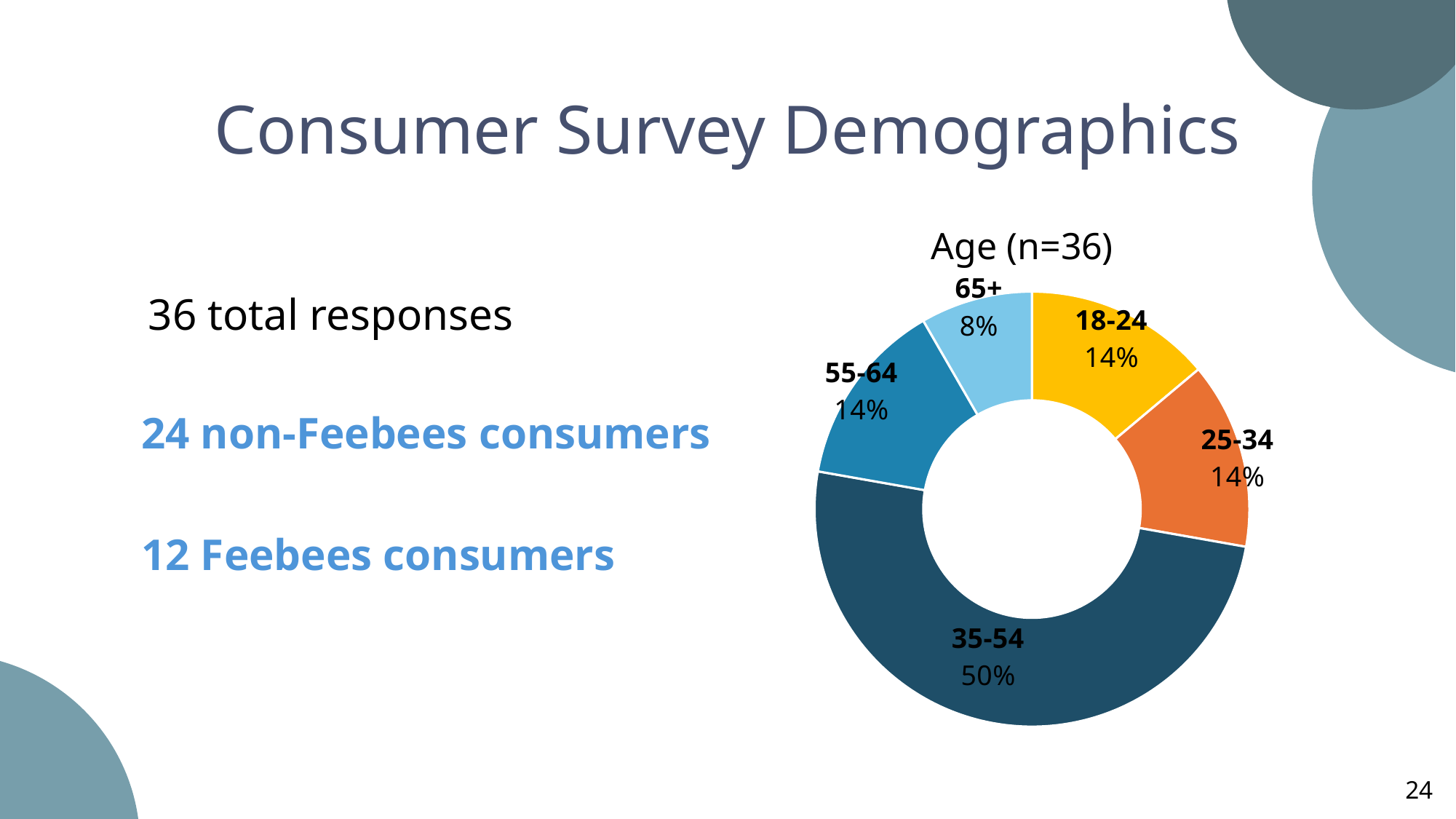
What share of respondents are in the 35-54 age group? 50% What is the difference in percentage points between the 35-54 and 55-64 age groups? 36 What is the title of the chart? Age (n=36) How many age groups are shown in the chart? 5 Which is larger, the share for 25-34 or the share for 65+? 25-34 Which age group has the smallest share of respondents? 65+ What is the combined share of the 18-24 and 25-34 age groups? 28% Which age group has the largest share of respondents? 35-54 What percentage of respondents are aged 65+? 8% What is the value shown for the 18-24 age group? 14% What kind of chart is used to show the age distribution? Doughnut (pie) chart What colour is the 35-54 segment of the chart? Dark blue